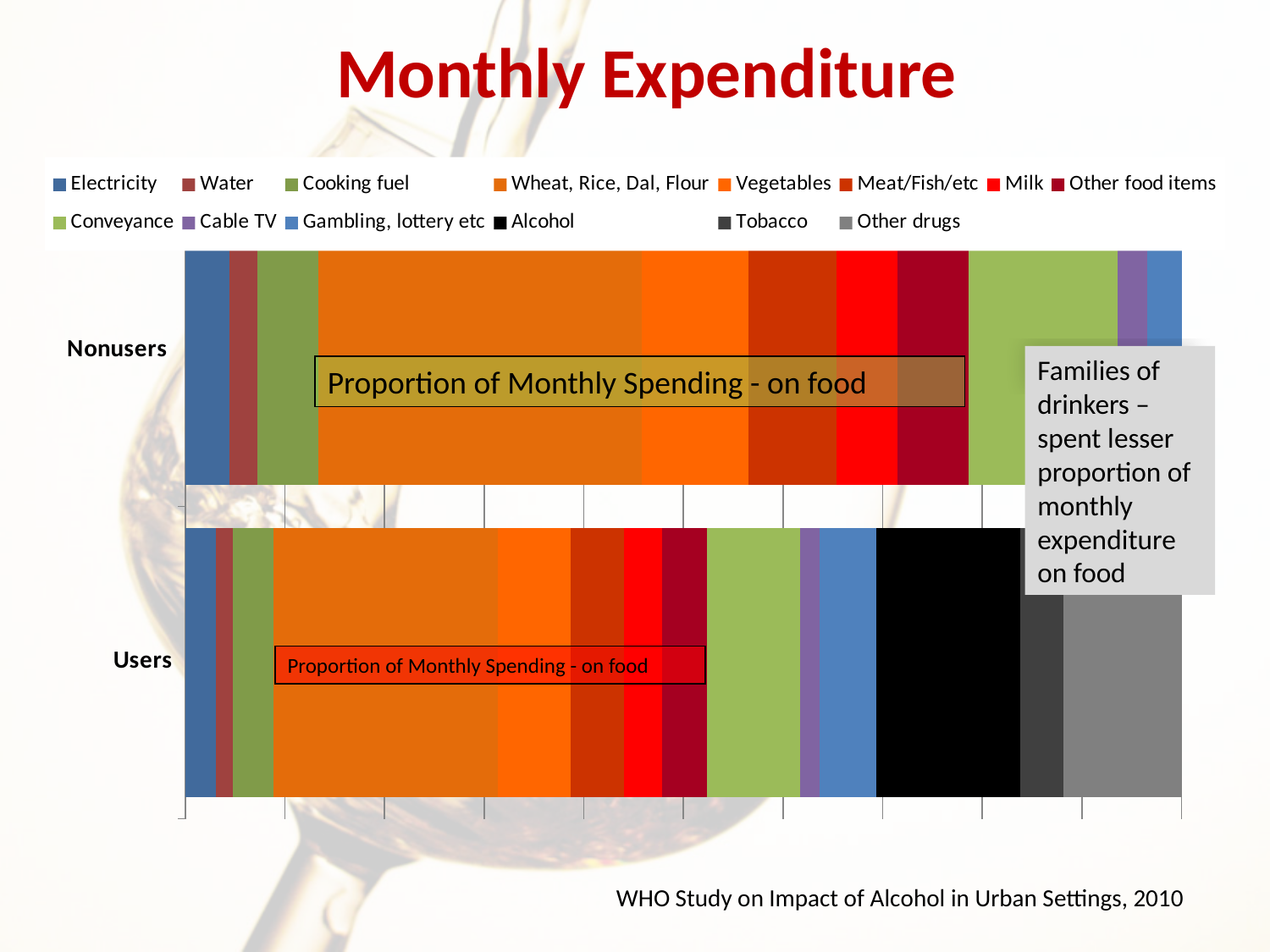
What are the two category labels on the chart's vertical axis? Nonusers and Users Which category, Nonusers or Users, has a larger Other drugs segment? Users What kind of chart is shown on the slide? Stacked bar chart Which category, Nonusers or Users, has a larger Tobacco segment? Users Which category, Nonusers or Users, has a larger Wheat, Rice, Dal, Flour segment? Nonusers What is the title of the slide's chart? Monthly Expenditure How many series does the legend list? 14 How many categories (bars) does the chart show? 2 Which colour represents Alcohol in the legend? Black